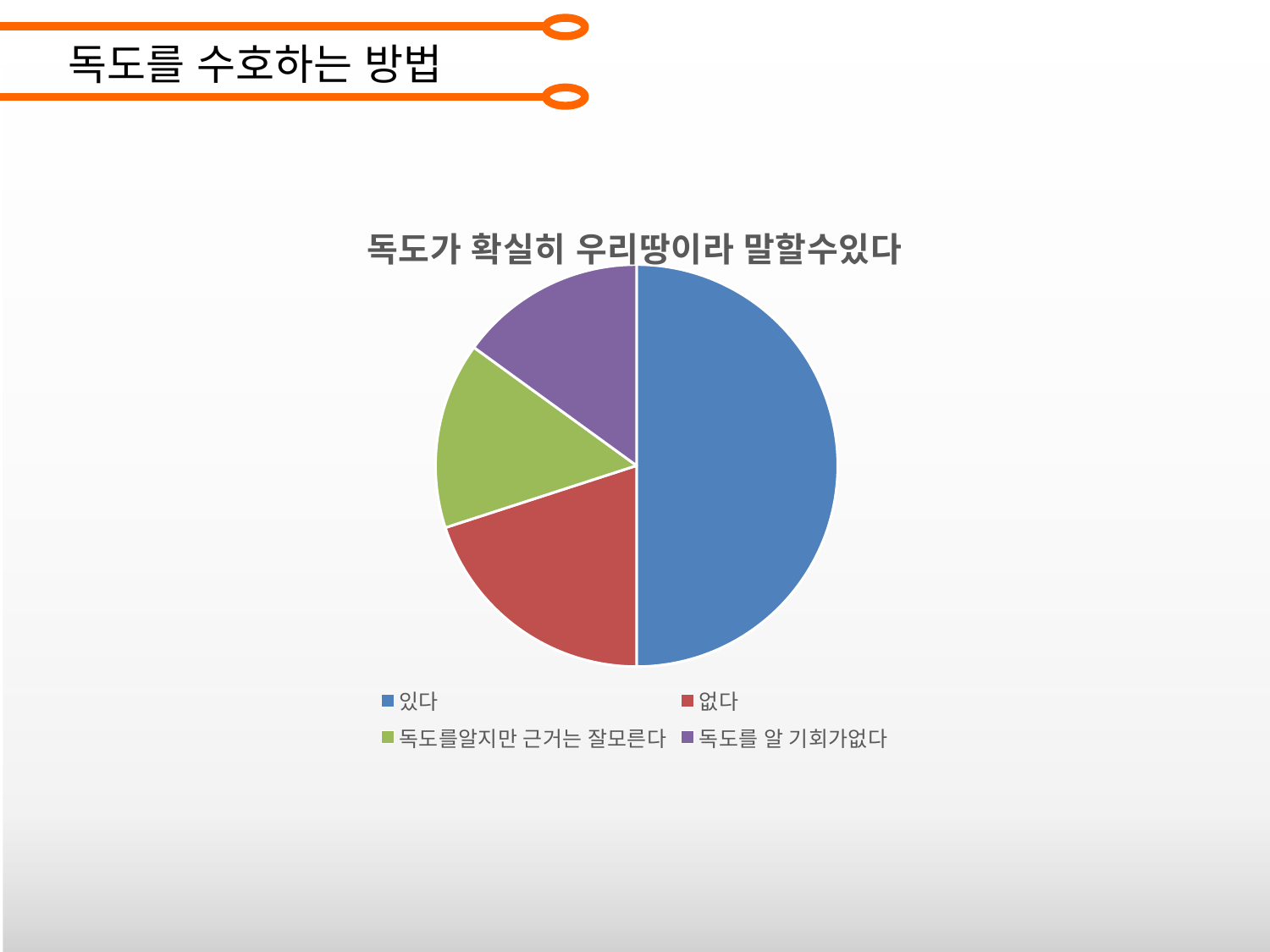
Which category has the largest slice in the pie chart? 있다 Which slice is larger, 없다 or 독도를알지만 근거는 잘모른다? 없다 Which category is shown in blue in the pie chart? 있다 Which slice is larger, 있다 or 독도를 알 기회가없다? 있다 How many entries does the legend of the pie chart list? 4 What kind of chart is shown on the slide? pie chart What is the title of the pie chart? 독도가 확실히 우리땅이라 말할수있다 Which slice is larger, 있다 or 없다? 있다 How many categories (slices) does the pie chart have? 4